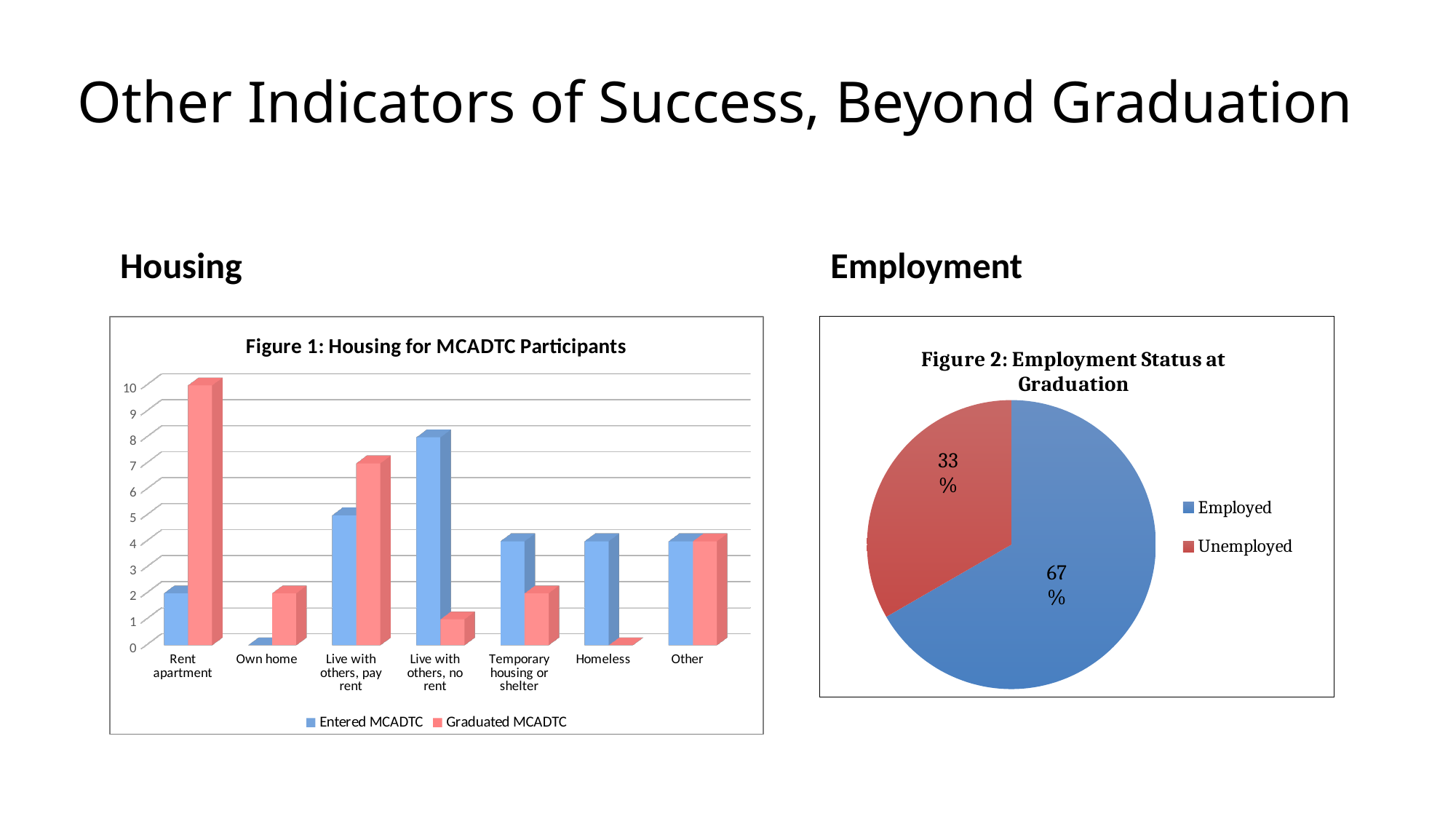
In Figure 1: Housing for MCADTC Participants, which category has the highest Entered MCADTC bar? Live with others, no rent In Figure 1: Housing for MCADTC Participants, which category has the highest Graduated MCADTC bar? Rent apartment What kind of chart is Figure 2: Employment Status at Graduation? pie chart What kind of chart is Figure 1: Housing for MCADTC Participants? bar chart In Figure 2: Employment Status at Graduation, which slice is larger, Employed or Unemployed? Employed How many series does the legend of Figure 1: Housing for MCADTC Participants list? 2 In Figure 1: Housing for MCADTC Participants, is the Entered MCADTC value for Homeless greater or less than 6? less In Figure 1: Housing for MCADTC Participants, is the Graduated MCADTC value for Rent apartment greater or less than 8? greater In Figure 2: Employment Status at Graduation, what share of participants were Unemployed? 33% In Figure 1: Housing for MCADTC Participants, which is larger for Live with others, no rent: the Entered MCADTC bar or the Graduated MCADTC bar? Entered MCADTC How many housing categories are shown on the x axis of Figure 1: Housing for MCADTC Participants? 7 In Figure 2: Employment Status at Graduation, what share of participants were Employed? 67%